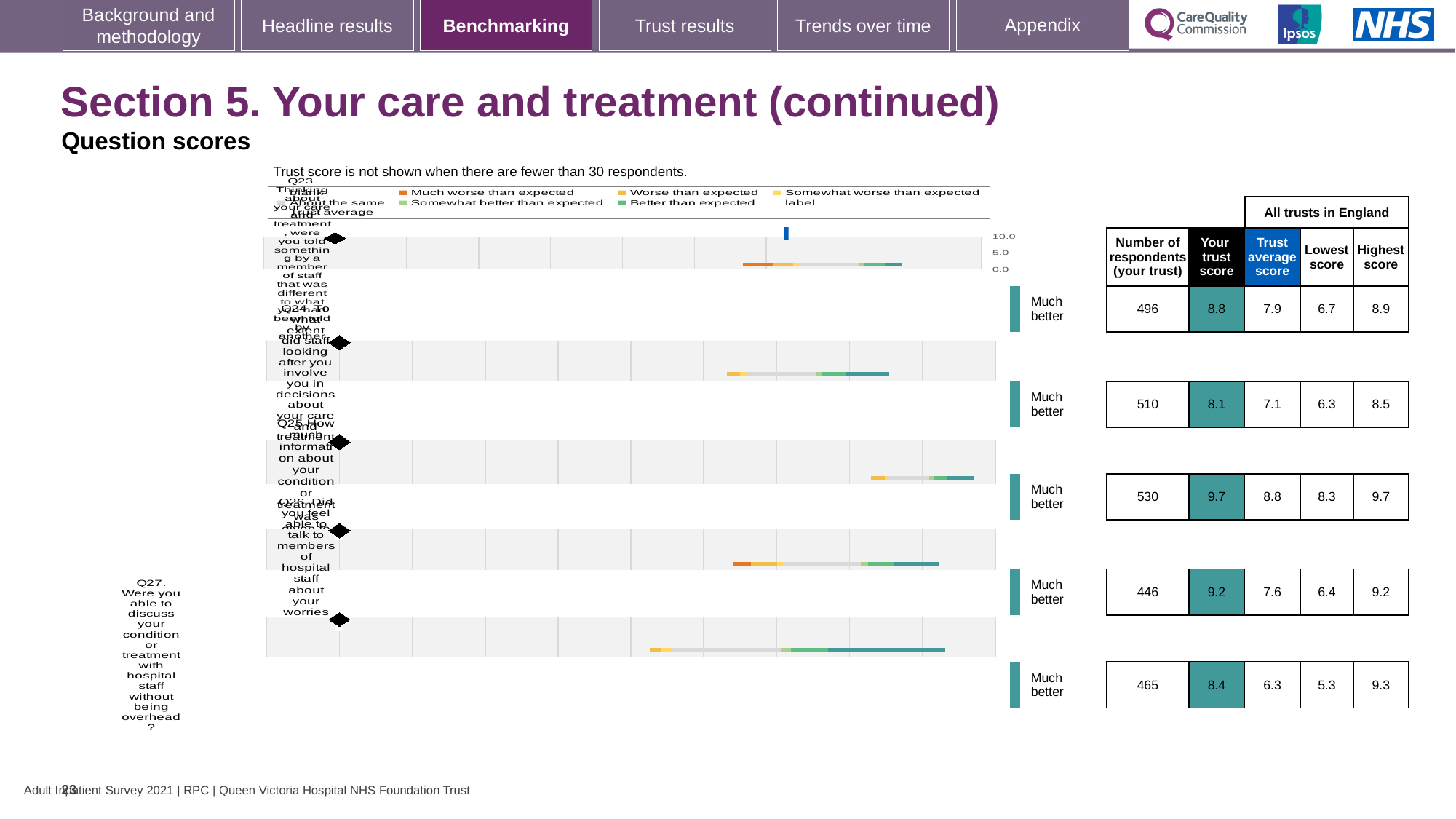
What kind of chart is used to show the question scores? Bar chart What is the 'Trust average score' for Q27 (Were you able to discuss your condition or treatment with hospital staff without being overheard)? 6.3 How many questions (rows) are plotted in the benchmarking chart? 5 What is the 'Your trust score' value for Q24 (Did staff looking after you involve you in decisions about your care and treatment)? 8.1 How many respondents are shown for Q25 (How much information about your condition or treatment was given to you)? 530 What is the 'Lowest score' value shown for Q23? 6.7 For Q27, what is the difference between 'Your trust score' and the 'Trust average score'? 2.1 Which has the larger 'Your trust score': Q23 or Q26? Q26 Which question has the lowest 'Your trust score' on this slide? Q24 Which question has the highest 'Your trust score' on this slide? Q25 What is the 'Highest score' value shown for Q26 (Did you feel able to talk to members of hospital staff about your worries)? 9.2